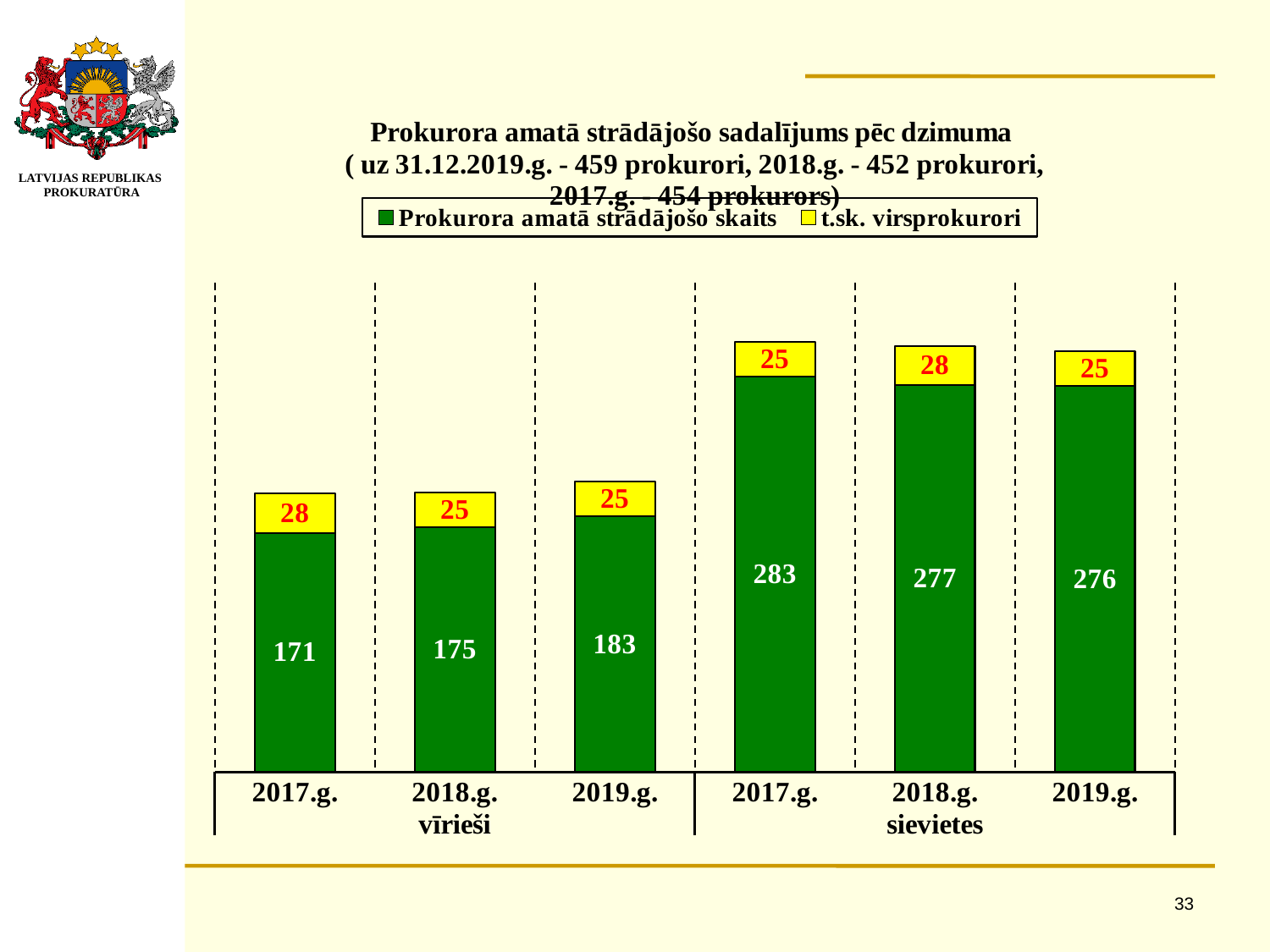
What is the value of the yellow series (t.sk. virsprokurori) for sievietes in 2018.g.? 28 What is the value of the green series (Prokurora amatā strādājošo skaits) for sievietes in 2019.g.? 276 What is the difference between the green series values for sievietes 2017.g. and vīrieši 2017.g.? 112 Which bar has the highest value for the green series (Prokurora amatā strādājošo skaits)? sievietes 2017.g. What is the value of the yellow series (t.sk. virsprokurori) for vīrieši in 2019.g.? 25 How many bars are shown in the chart? 6 Which bar has the lowest value for the green series (Prokurora amatā strādājošo skaits)? vīrieši 2017.g. What is the difference between the green series values for vīrieši 2019.g. and vīrieši 2018.g.? 8 How many series does the legend list? 2 What kind of chart is shown on the slide? stacked bar chart Which is larger for the green series: sievietes 2018.g. or sievietes 2019.g.? sievietes 2018.g. What is the value of the green series (Prokurora amatā strādājošo skaits) for vīrieši in 2017.g.? 171